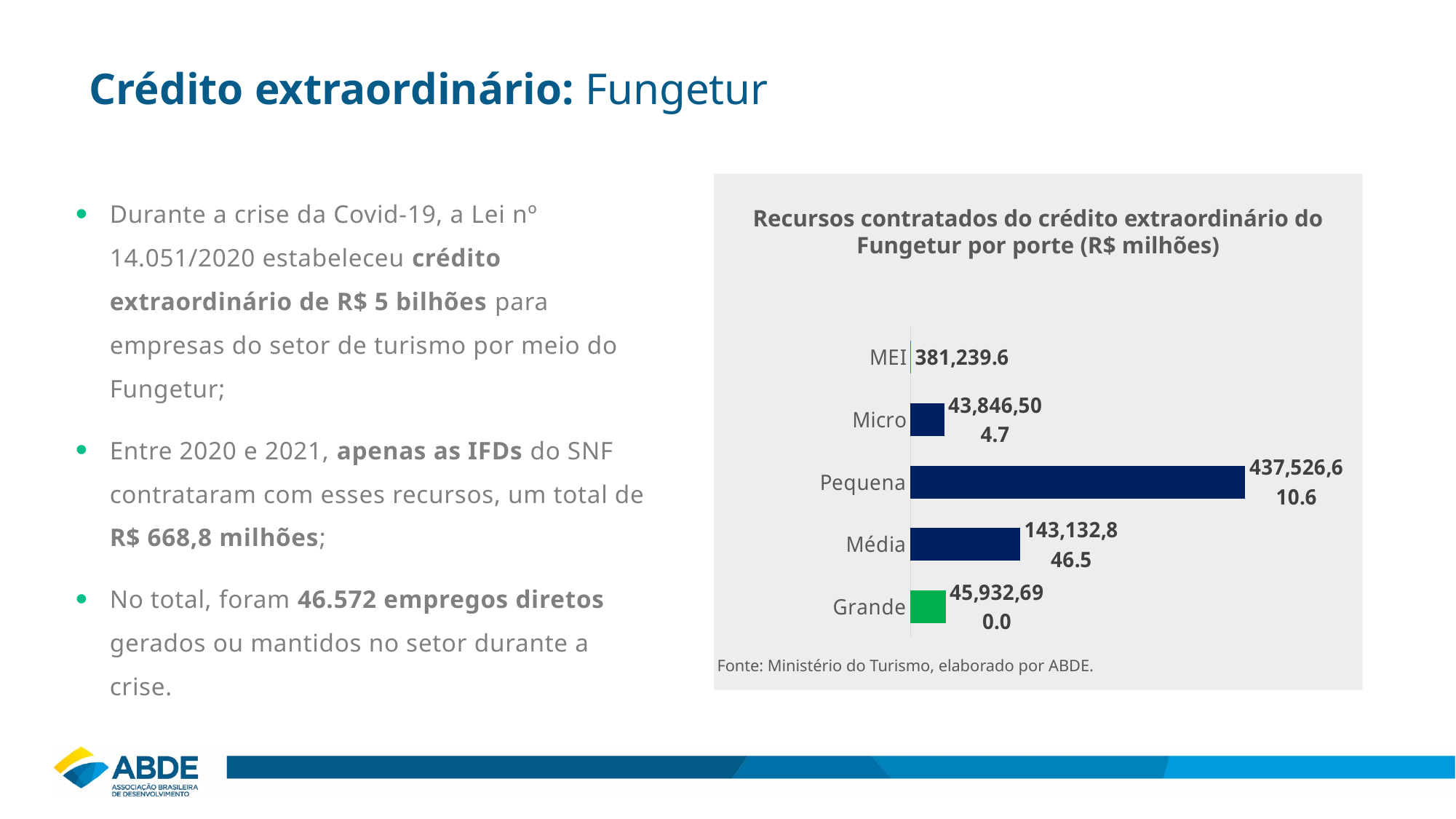
Which category's bar is coloured green instead of dark blue? Grande What is the title of the chart? Recursos contratados do crédito extraordinário do Fungetur por porte (R$ milhões) Which category has the highest value in the chart? Pequena How many categories (portes) are shown in the chart? 5 What is the value shown for Média? 143,132,846.5 Which is larger, the value for Pequena or the value for Média? Pequena What kind of chart is shown on the slide? bar chart What is the value shown for Pequena? 437,526,610.6 What is the value shown for MEI? 381,239.6 Which category has the lowest value in the chart? MEI Which is larger, the value for Média or the value for Micro? Média